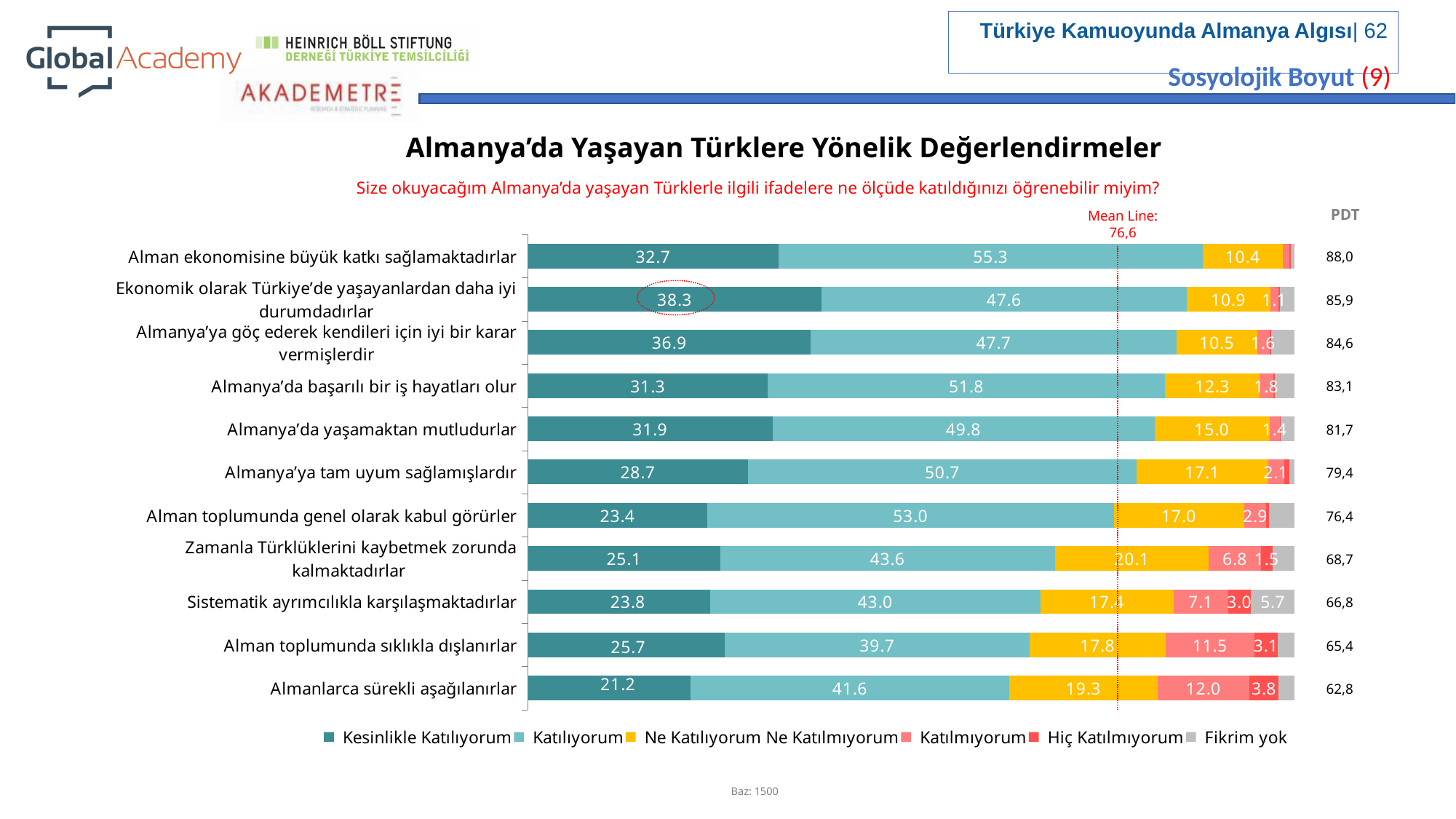
How many statements (categories) are plotted in the chart? 11 How many series does the legend list? 6 What is the "Katılıyorum" value for "Almanya'da başarılı bir iş hayatları olur"? 51.8 What is the difference between the "Katılıyorum" values for "Alman ekonomisine büyük katkı sağlamaktadırlar" and "Almanlarca sürekli aşağılanırlar"? 13.7 Which has the larger "Katılıyorum" value: "Alman toplumunda genel olarak kabul görürler" or "Zamanla Türklüklerini kaybetmek zorunda kalmaktadırlar"? Alman toplumunda genel olarak kabul görürler Which statement has the highest "Kesinlikle Katılıyorum" value? Ekonomik olarak Türkiye'de yaşayanlardan daha iyi durumdadırlar What is the "Kesinlikle Katılıyorum" value for "Alman ekonomisine büyük katkı sağlamaktadırlar"? 32.7 What is the "Fikrim yok" value for "Sistematik ayrımcılıkla karşılaşmaktadırlar"? 5.7 What is the "Hiç Katılmıyorum" value for "Almanlarca sürekli aşağılanırlar"? 3.8 Which statement has the lowest "Kesinlikle Katılıyorum" value? Almanlarca sürekli aşağılanırlar What value is shown for the Mean Line on the chart? 76,6 What kind of chart is shown on the slide? bar chart